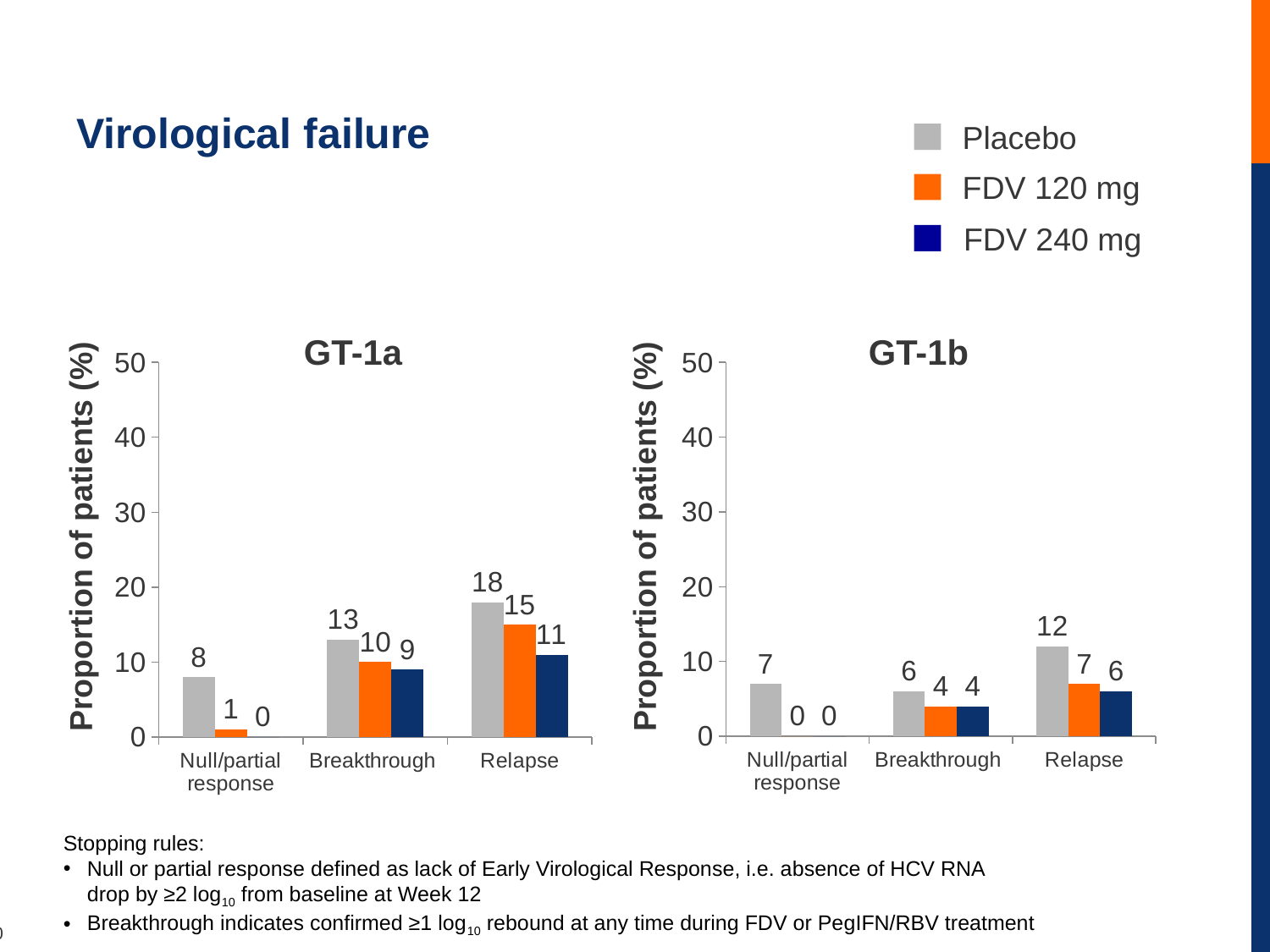
In the GT-1b chart, what is the difference between the Placebo and FDV 120 mg values in the Relapse category? 5 How many categories are shown on the x axis of the GT-1b chart? 3 How many series does the legend list? 3 In the GT-1a chart, what is the value for Placebo in the Relapse category? 18 What kind of chart is the GT-1a chart? Bar chart In the GT-1a chart, which is larger in the Breakthrough category: Placebo or FDV 120 mg? Placebo In the GT-1a chart, which category has the lowest FDV 120 mg value? Null/partial response In the GT-1a chart, what is the difference between the Placebo and FDV 240 mg values in the Relapse category? 7 In the GT-1b chart, what is the value for FDV 120 mg in the Breakthrough category? 4 In the GT-1b chart, which category has the highest Placebo value? Relapse In the GT-1a chart, what is the value for FDV 240 mg in the Null/partial response category? 0 What is the y-axis label of the GT-1b chart? Proportion of patients (%)